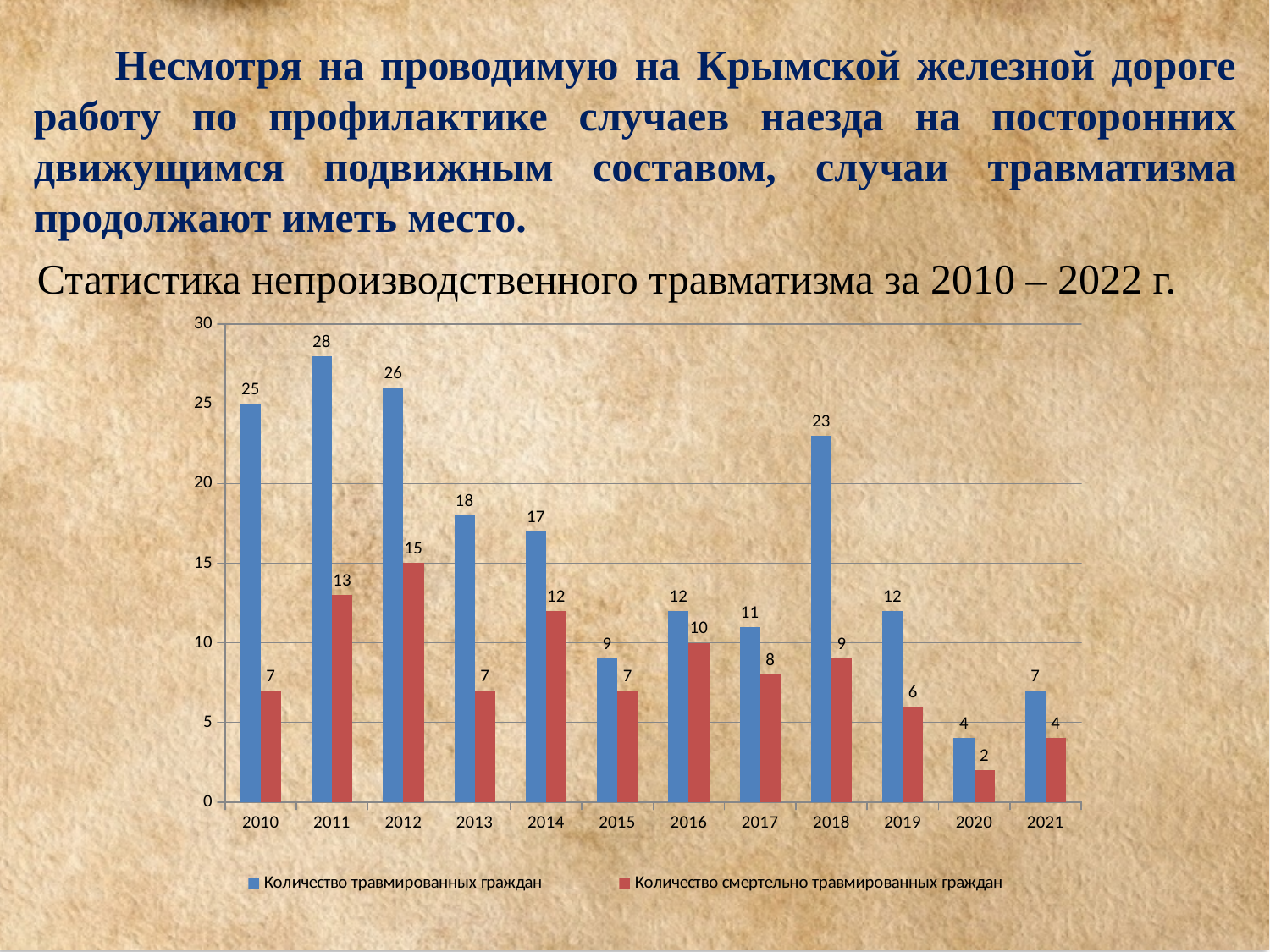
What is the value for Количество смертельно травмированных граждан in 2012? 15 What is the difference between Количество травмированных граждан and Количество смертельно травмированных граждан in 2018? 14 Which year has the highest value for Количество травмированных граждан? 2011 Is the value for Количество травмированных граждан in 2012 greater or less than 25? greater How many series does the legend list? 2 How many years are shown on the x axis? 12 Does Количество травмированных граждан rise or fall from 2018 to 2020? fall What type of chart is shown on the slide? bar chart Which is larger: Количество травмированных граждан in 2013 or in 2014? 2013 Which year has the lowest value for Количество смертельно травмированных граждан? 2020 What is the value for Количество травмированных граждан in 2011? 28 Which colour represents Количество смертельно травмированных граждан in the legend? red